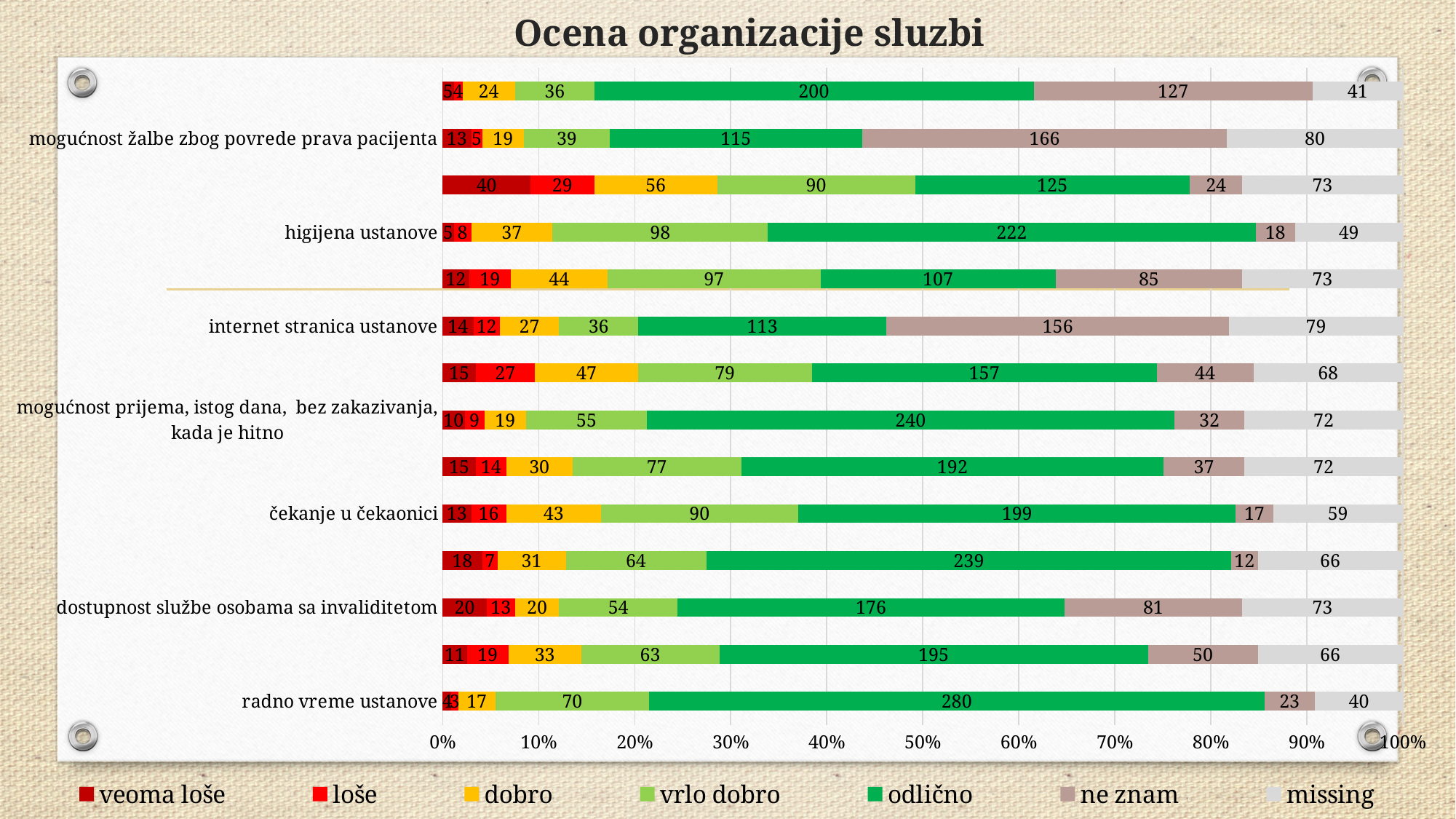
How many series does the legend list? 7 What is the 'ne znam' value for 'internet stranica ustanove'? 156 What type of chart is shown on the slide? stacked bar chart Which category has the highest 'ne znam' value? mogućnost žalbe zbog povrede prava pacijenta What is the difference between the 'odlično' values for 'higijena ustanove' and 'internet stranica ustanove'? 109 What is the 'missing' value for 'dostupnost službe osobama sa invaliditetom'? 73 Which is larger: the 'odlično' value for 'mogućnost prijema, istog dana, bez zakazivanja, kada je hitno' or for 'dostupnost službe osobama sa invaliditetom'? mogućnost prijema, istog dana, bez zakazivanja, kada je hitno What is the total of all segments in the 'higijena ustanove' bar? 437 What is the 'odlično' value for 'higijena ustanove'? 222 What is the title of the chart? Ocena organizacije sluzbi Which category has the highest 'odlično' value? radno vreme ustanove What is the 'vrlo dobro' value for 'čekanje u čekaonici'? 90